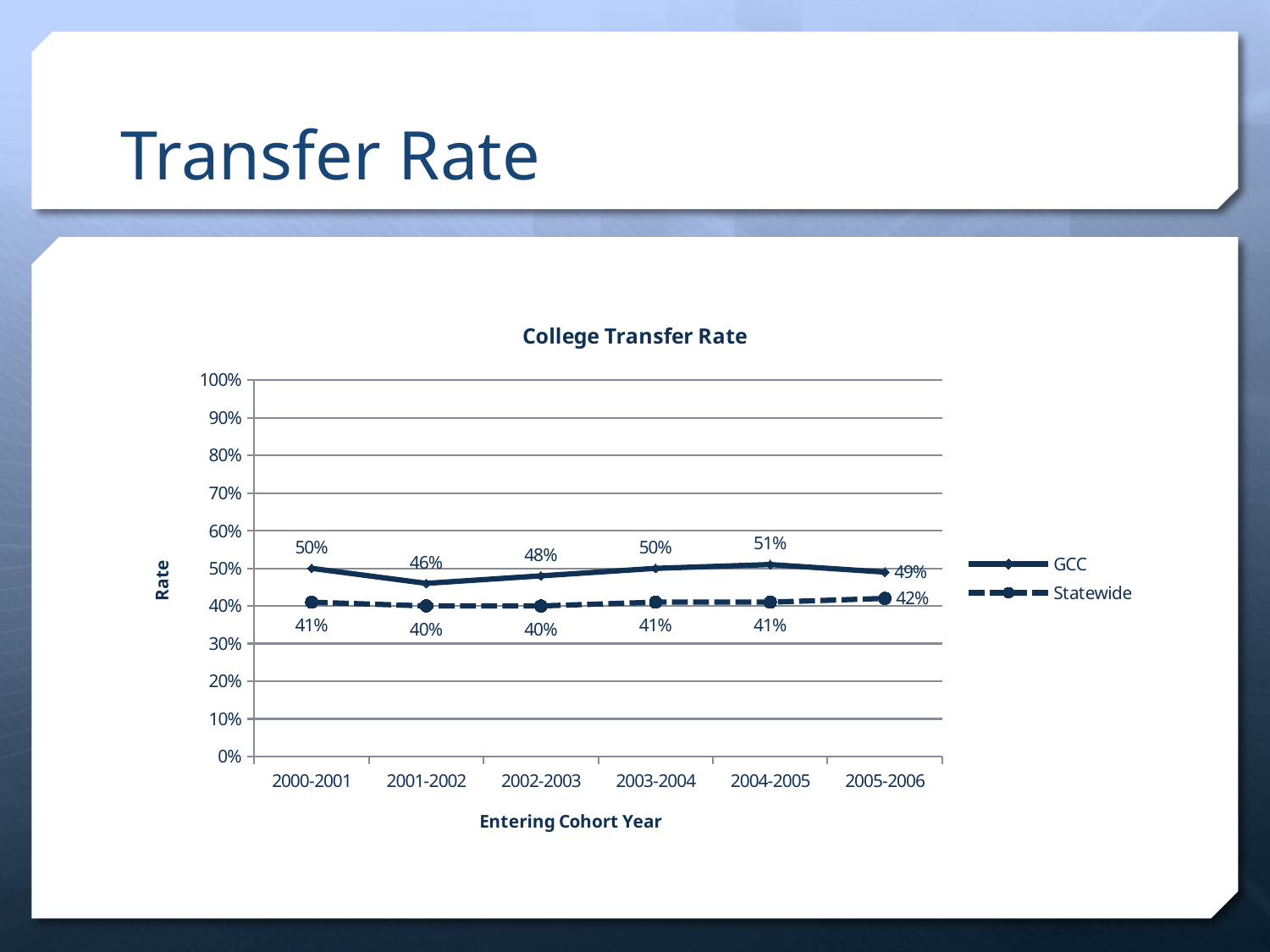
Which series has the higher transfer rate for the 2002-2003 cohort, GCC or Statewide? GCC What is the GCC transfer rate for the 2004-2005 entering cohort? 51% What is the label of the x axis? Entering Cohort Year What kind of chart is shown on the slide? Line chart What is the title of the chart? College Transfer Rate What is the Statewide transfer rate for the 2005-2006 entering cohort? 42% Which entering cohort year has the lowest GCC transfer rate? 2001-2002 How many entering cohort years are shown on the x axis? 6 What is the GCC transfer rate for the 2001-2002 entering cohort? 46% Which entering cohort year has the highest GCC transfer rate? 2004-2005 How many series does the legend list? 2 What is the difference between the GCC and Statewide transfer rates for the 2004-2005 cohort? 10%